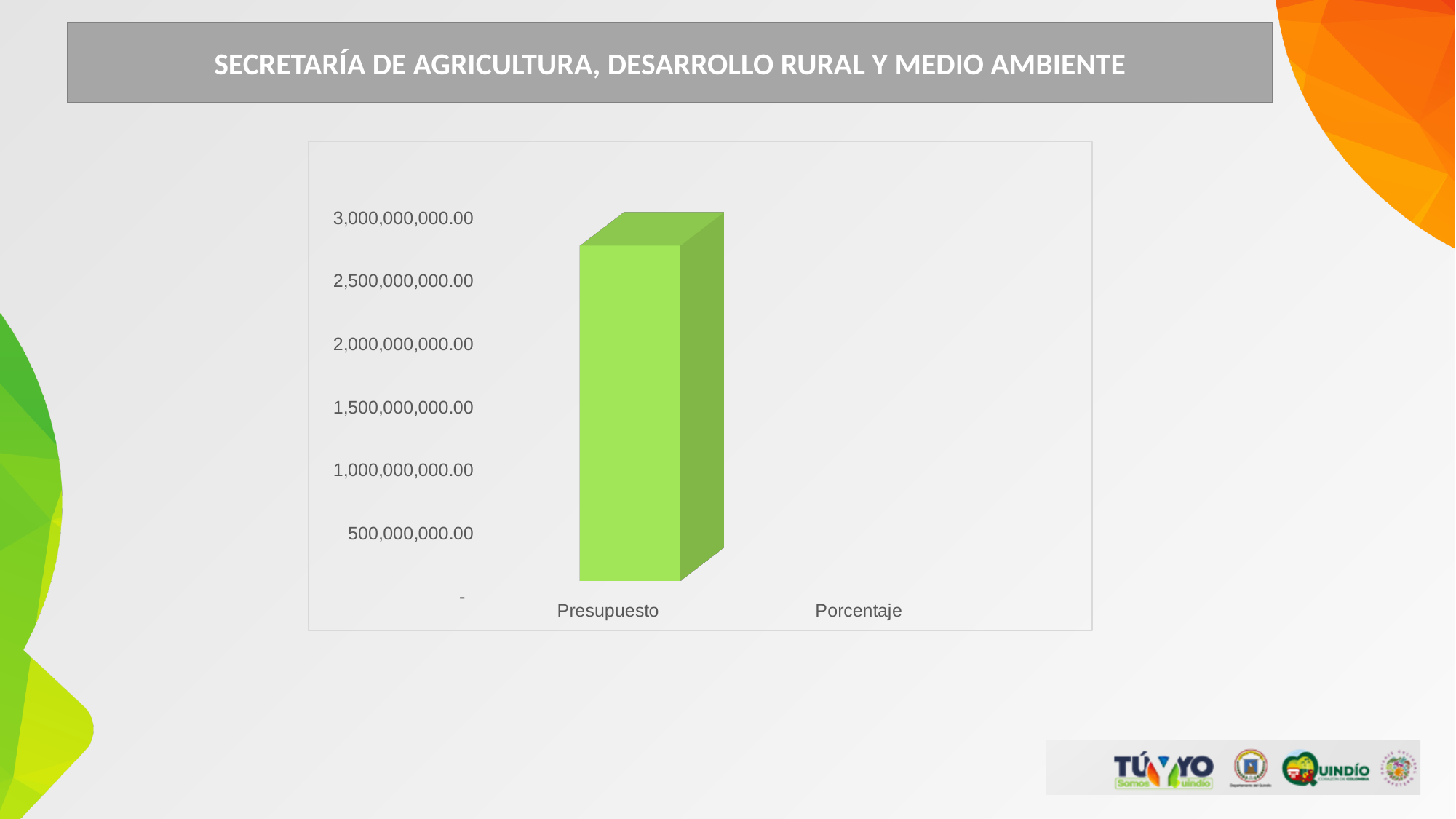
Which category has the highest value in the chart? Presupuesto How many categories are shown on the x axis of the chart? 2 What is the highest tick label shown on the vertical axis of the chart? 3,000,000,000.00 Is the value for Porcentaje greater or less than 500,000,000.00? less What kind of chart is shown on the slide? bar chart Is the value for Presupuesto greater or less than 3,000,000,000.00? less What colour is the bar for Presupuesto? green Which is larger, the value for Presupuesto or the value for Porcentaje? Presupuesto Is the value for Presupuesto greater or less than 2,500,000,000.00? greater Which category has the lowest value in the chart? Porcentaje